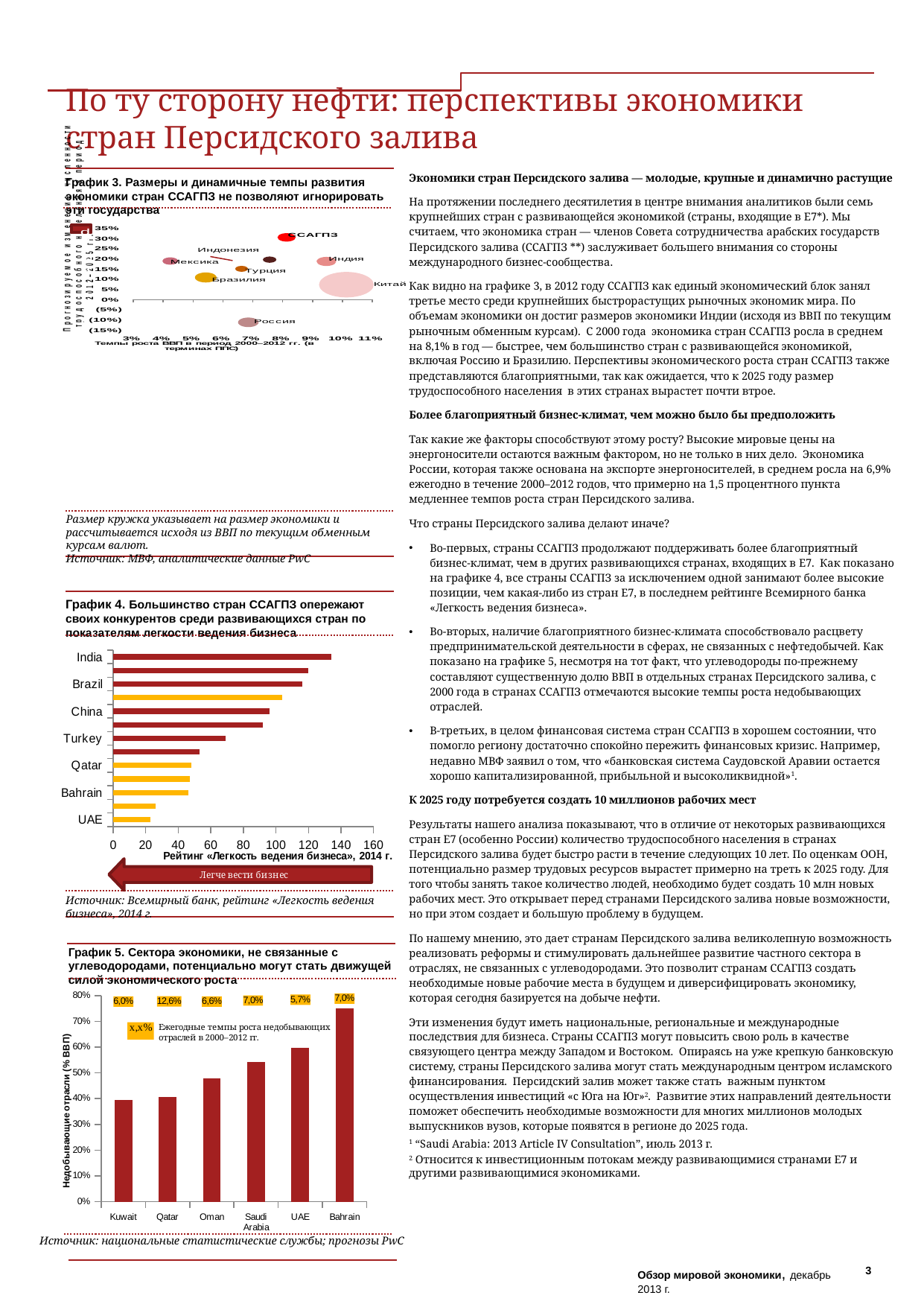
In График 4, which labelled country has the longest bar in the Ease of Doing Business ranking? India In График 5, is the value for Bahrain greater or less than 70%? greater In График 5, what is the difference between the labelled growth rates of Qatar and Kuwait? 6,6 percentage points In График 3, is the value for Россия on the vertical axis greater or less than 0%? less In График 5, what annual growth rate of non-hydrocarbon sectors is shown above the bar for Qatar? 12,6% In График 5, which country has the lowest labelled annual growth rate of non-hydrocarbon sectors? UAE In График 4, is the value for UAE greater or less than 40? less In График 5, what annual growth rate label is shown above the bar for UAE? 5,7% In График 5, which country has the tallest bar for non-hydrocarbon sectors as % of GDP? Bahrain In График 4, what kind of chart is used? Bar chart In График 5, how many countries are shown on the x axis? 6 In График 5, which country has the highest labelled annual growth rate of non-hydrocarbon sectors? Qatar